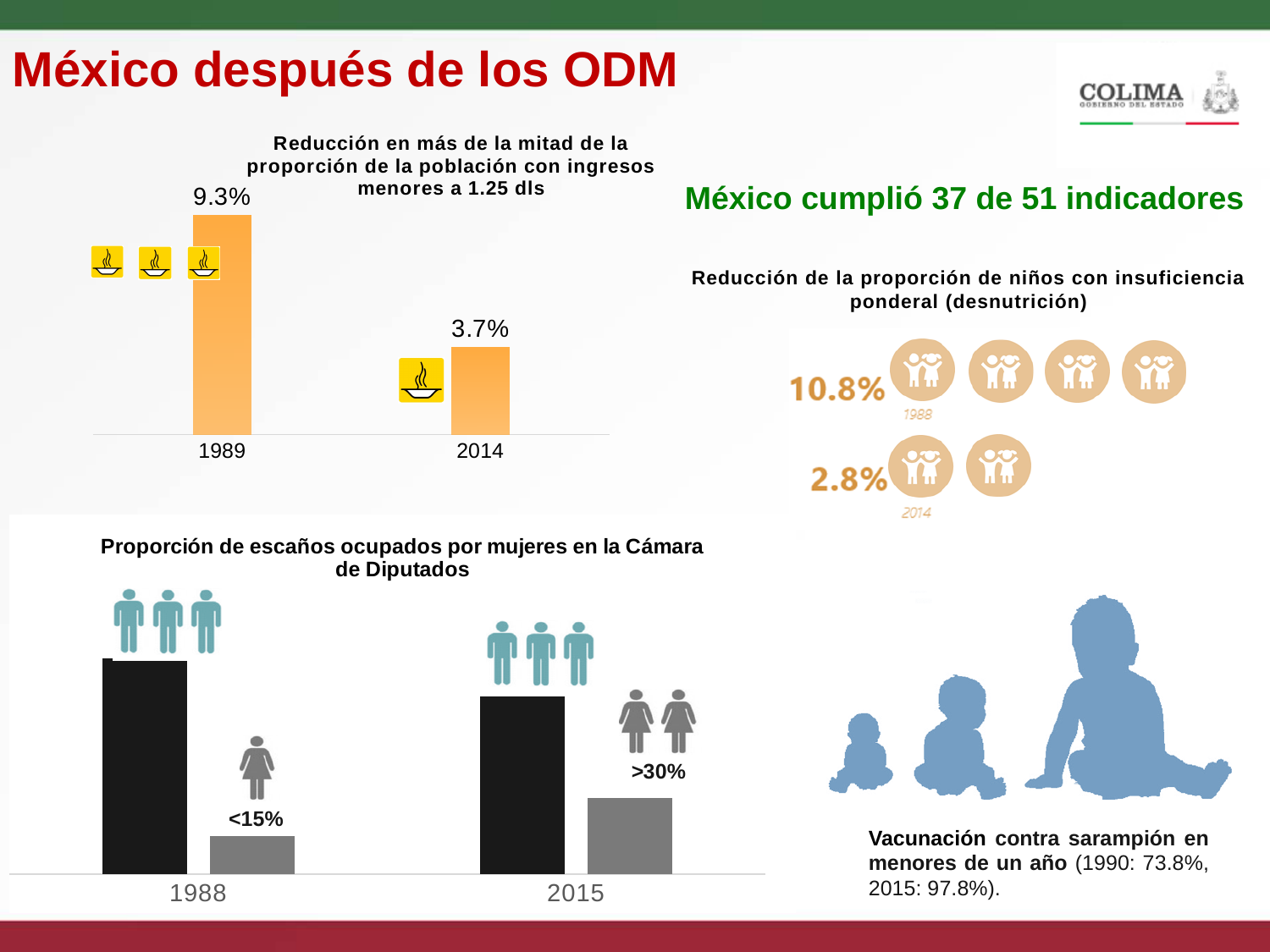
In the top-right graphic on the reduction of children with insufficient weight (desnutrición), what is the value for 1988? 10.8% In the top-left chart on the population with income below 1.25 dollars, which year has the higher value, 1989 or 2014? 1989 In the bottom-left chart on seats held by women in the Cámara de Diputados, what label is shown for the women's bar in 1988? <15% In the top-left chart on the population with income below 1.25 dollars, do the values rise or fall from 1989 to 2014? Fall In the bottom-left chart on seats held by women in the Cámara de Diputados, what label is shown for the women's bar in 2015? >30% In the top-left chart on the reduction of the population with income below 1.25 dollars, what is the value for 1989? 9.3% In the top-right graphic on children with insufficient weight, what is the difference between the 1988 and 2014 values? 8.0 percentage points What kind of chart is the top-left chart on the population with income below 1.25 dollars? Bar chart In the top-left chart on the reduction of the population with income below 1.25 dollars, what is the value for 2014? 3.7% In the top-right graphic on the reduction of children with insufficient weight (desnutrición), what is the value for 2014? 2.8% In the top-left chart on the population with income below 1.25 dollars, what is the difference between the 1989 and 2014 values? 5.6 percentage points How many years are shown in the top-left chart on the population with income below 1.25 dollars? 2